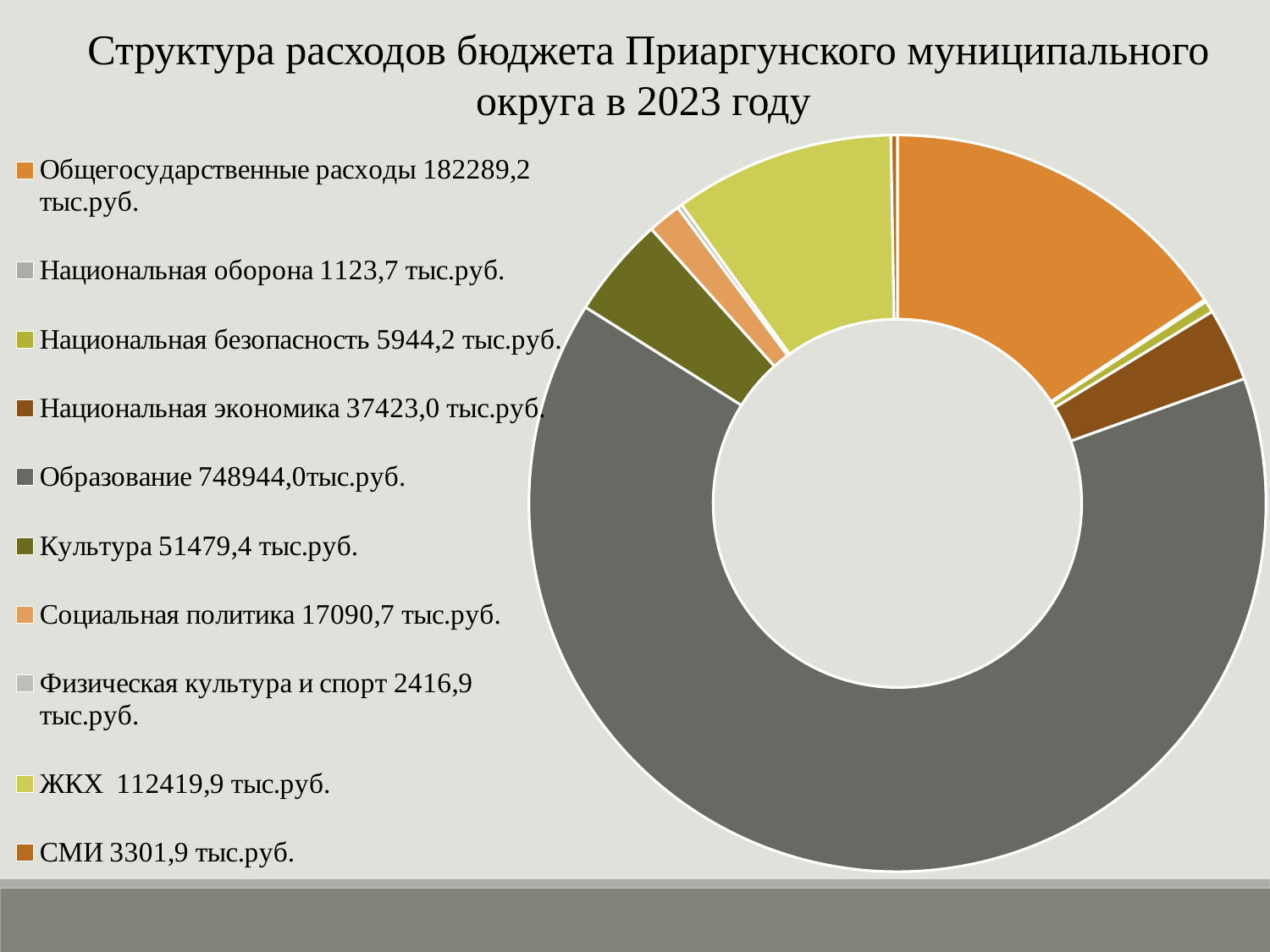
What is the difference between Общегосударственные расходы and ЖКХ? 69869,3 тыс.руб. Which category has the smallest expenditure? Национальная оборона Which is larger, Национальная экономика or Социальная политика? Национальная экономика What is the value for Общегосударственные расходы? 182289,2 тыс.руб. What is the value for Социальная политика? 17090,7 тыс.руб. Which category has the largest expenditure? Образование What is the title of the chart? Структура расходов бюджета Приаргунского муниципального округа в 2023 году How many expenditure categories does the chart show? 10 What is the difference between Культура and Национальная экономика? 14056,4 тыс.руб. What type of chart is shown on the slide? Doughnut (pie) chart What is the value for ЖКХ? 112419,9 тыс.руб. What is the value for Образование? 748944,0 тыс.руб.